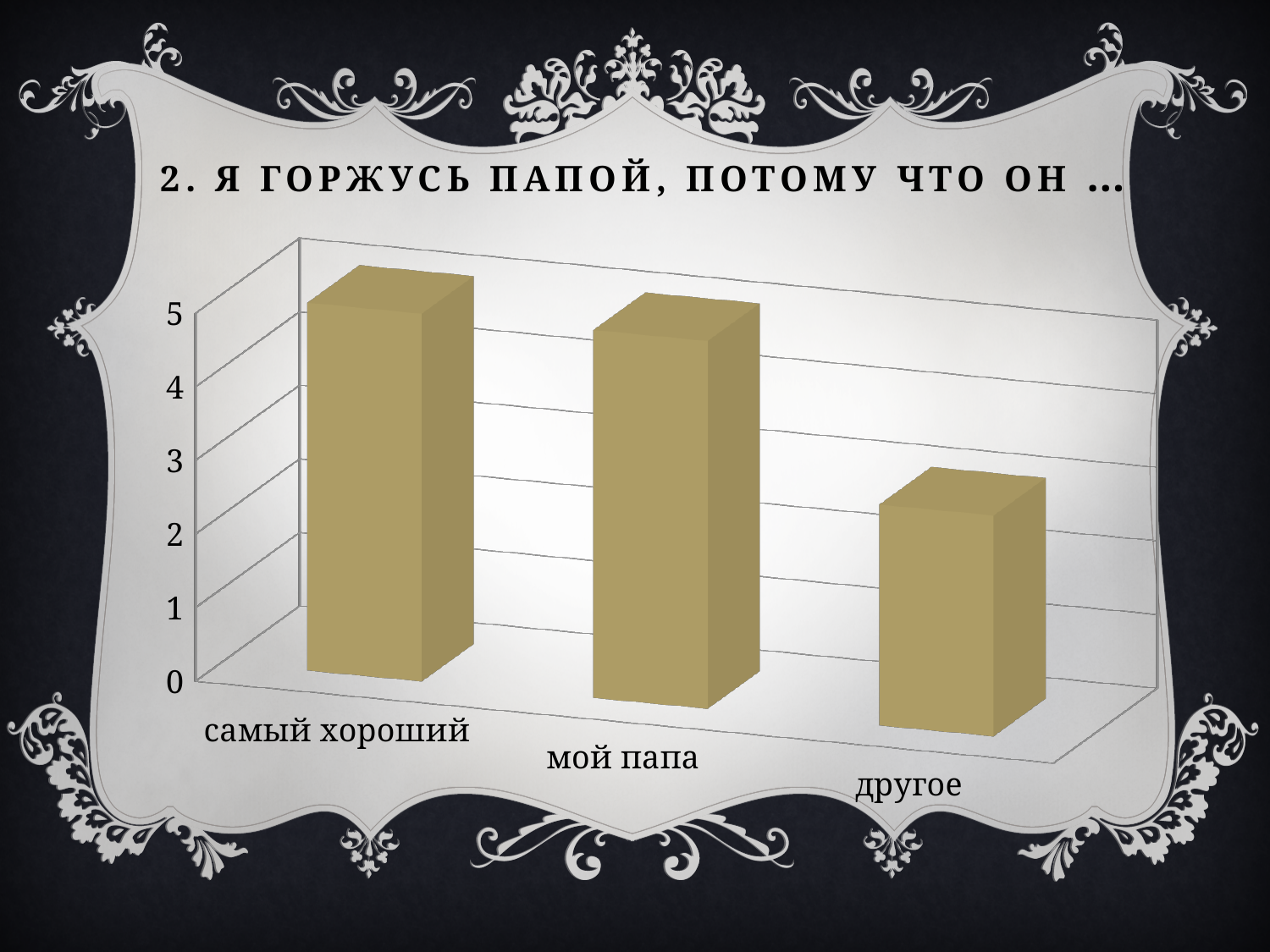
What kind of chart is shown on the slide? bar chart Which bar is taller: "мой папа" or "другое"? мой папа What is the title of the slide containing the chart? 2. Я горжусь папой, потому что он … Is the value for "самый хороший" greater or less than 4? greater Is the value for "другое" greater or less than 1? greater Is the value for "мой папа" greater or less than 3? greater Which bar is taller: "самый хороший" or "другое"? самый хороший Which category has the lowest bar in the chart? другое How many categories are shown on the x axis of the chart? 3 Do the bar heights rise or fall from left to right along the x axis? fall